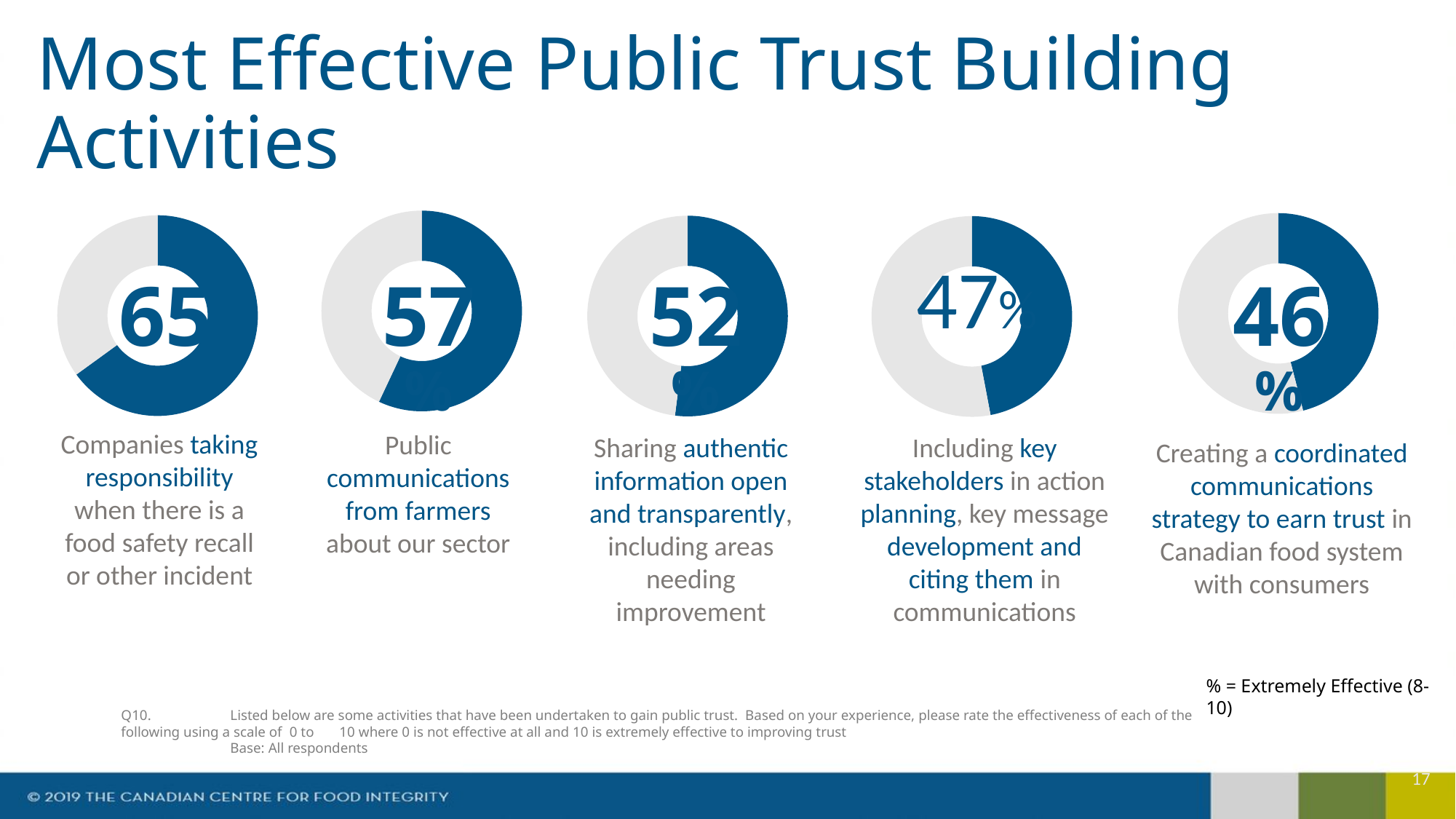
What is the difference in percentage points between 'Companies taking responsibility' (65) and 'Creating a coordinated communications strategy' (46%)? 19 What percentage is shown for 'Companies taking responsibility when there is a food safety recall or other incident'? 65 Which activity has the highest percentage rated extremely effective? Companies taking responsibility when there is a food safety recall or other incident What value is shown for 'Creating a coordinated communications strategy to earn trust in Canadian food system with consumers'? 46% What is the difference in percentage points between 'Public communications from farmers' and 'Sharing authentic information open and transparently'? 5 What value is shown in the donut chart for 'Public communications from farmers about our sector'? 57% What value is shown for 'Including key stakeholders in action planning, key message development and citing them in communications'? 47% What value is shown for 'Sharing authentic information open and transparently, including areas needing improvement'? 52% Which has a higher value: 'Public communications from farmers about our sector' or 'Sharing authentic information open and transparently'? Public communications from farmers about our sector According to the note on the slide, what does the percentage in each chart represent? Extremely Effective (8-10) Which activity has the lowest percentage rated extremely effective? Creating a coordinated communications strategy to earn trust in Canadian food system with consumers How many donut charts are shown on the slide? 5